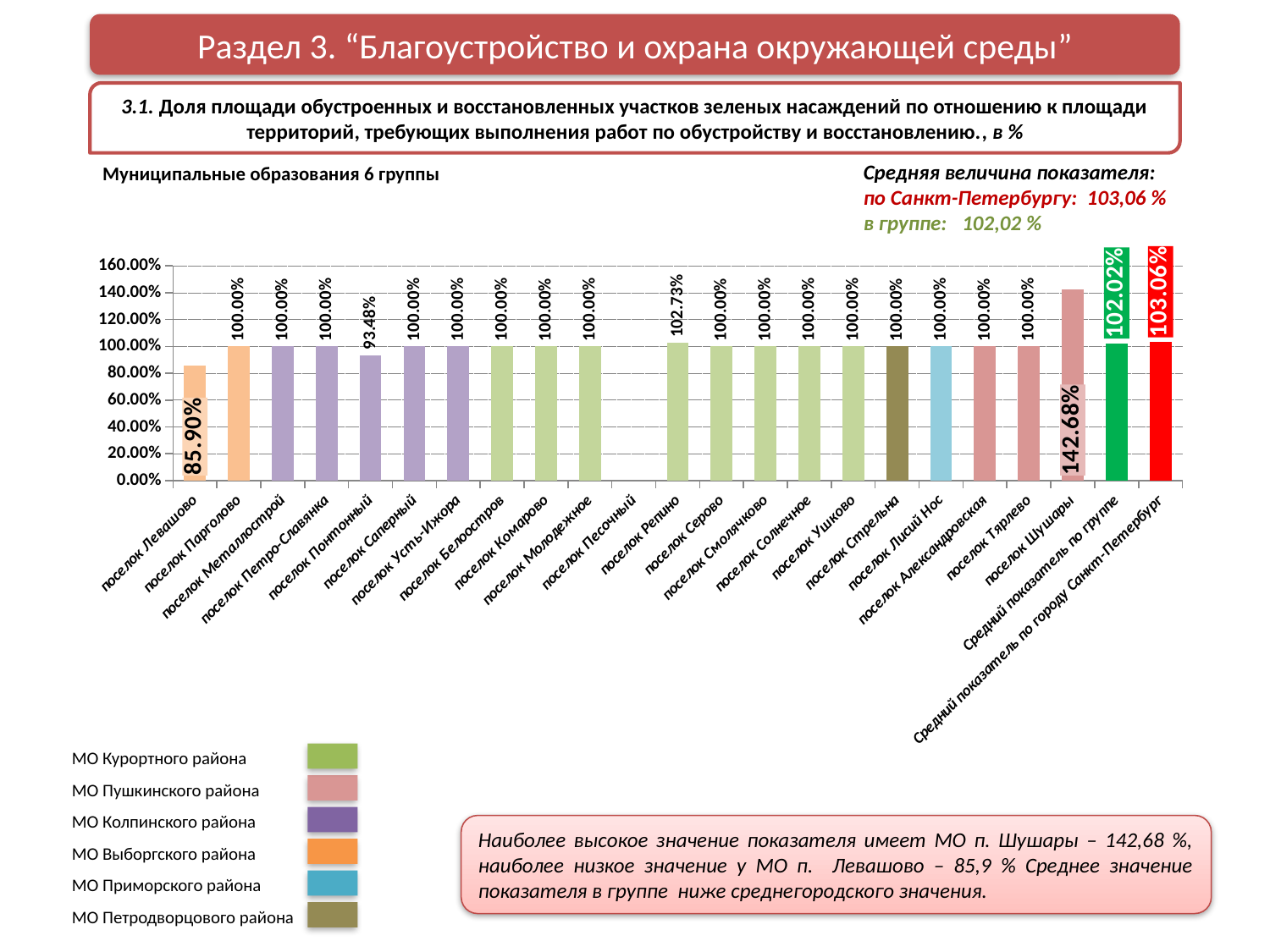
What is the value for поселок Левашово? 85.90% What kind of chart is shown on the slide? bar chart Which category has the highest value? поселок Шушары What is the value for поселок Репино? 102.73% What is the value shown for Средний показатель по группе? 102.02% Which category has the lowest plotted value? поселок Левашово What is the value for поселок Понтонный? 93.48% What colour are the bars for МО Курортного района according to the legend? green What is the value for поселок Шушары? 142.68% What is the difference between the values for поселок Шушары and поселок Левашово? 56.78 percentage points Is the value for поселок Левашово greater or less than 100.00%? less Which is larger, the value for поселок Репино or for поселок Понтонный? поселок Репино